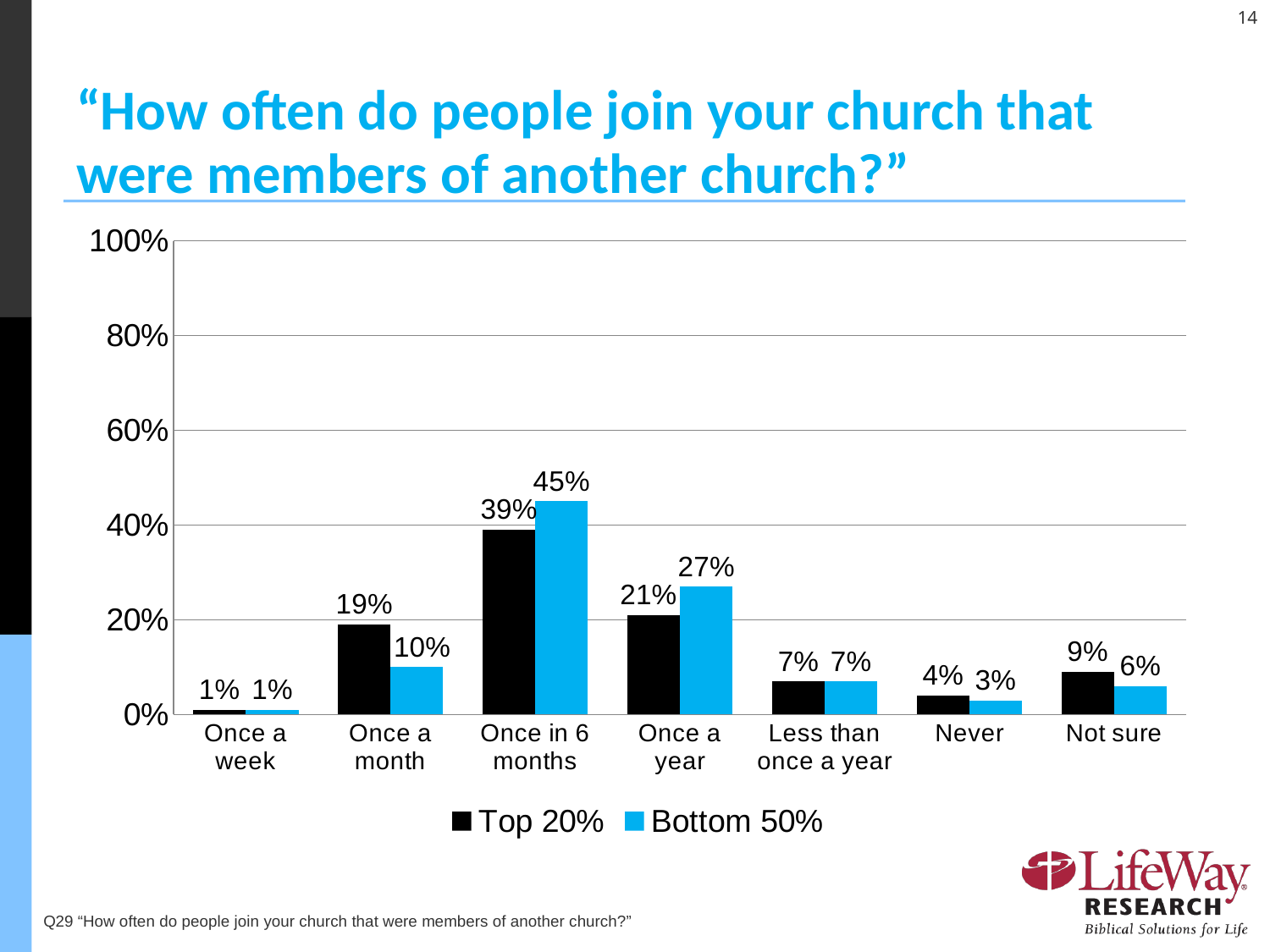
Which series is shown in black? Top 20% Which category has the lowest Top 20% value? Once a week How many series does the legend list? 2 Which category has the highest Bottom 50% value? Once in 6 months What is the Bottom 50% value for "Once a month"? 10% What is the Bottom 50% value for "Once a year"? 27% How many categories are shown on the x axis? 7 Which is larger for "Never": the Top 20% value or the Bottom 50% value? Top 20% What kind of chart is shown on the slide? Bar chart What is the difference between the Bottom 50% and Top 20% values for "Once in 6 months"? 6% What is the Top 20% value for "Once in 6 months"? 39% What is the difference between the Top 20% and Bottom 50% values for "Once a month"? 9%